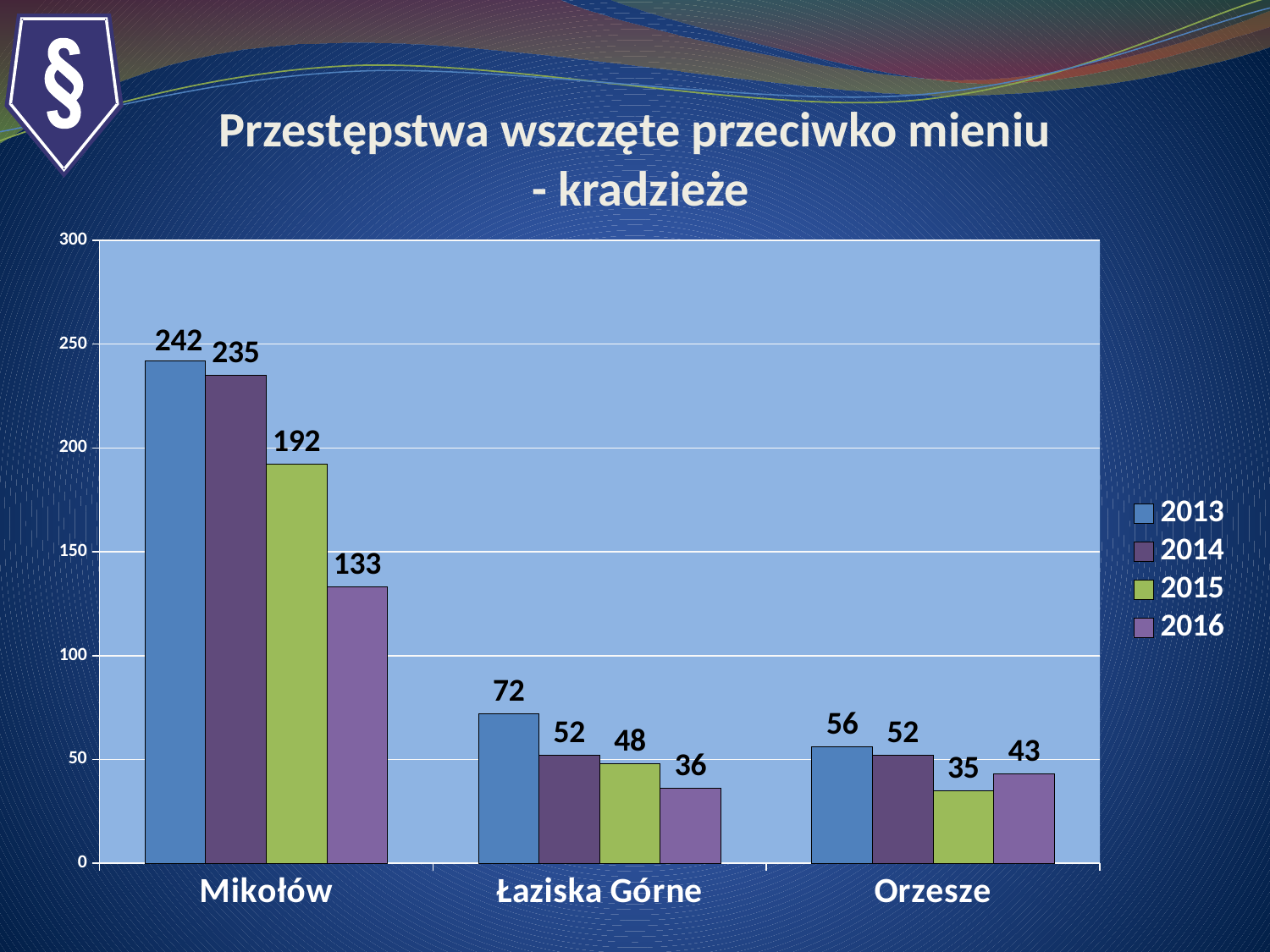
Is the value for Mikołów in 2015 greater or less than 150? greater What is the value for Orzesze in 2015? 35 What is the value for Mikołów in 2013? 242 Which is larger for Orzesze: the 2015 value or the 2016 value? 2016 Which category has the lowest value in 2015? Orzesze How many categories are shown on the x axis? 3 Do the values for Mikołów rise or fall from 2013 to 2016? fall What kind of chart is shown on the slide? bar chart How many series does the legend list? 4 What is the difference between the 2013 and 2016 values for Mikołów? 109 Which category has the highest value in 2014? Mikołów What is the value for Łaziska Górne in 2016? 36